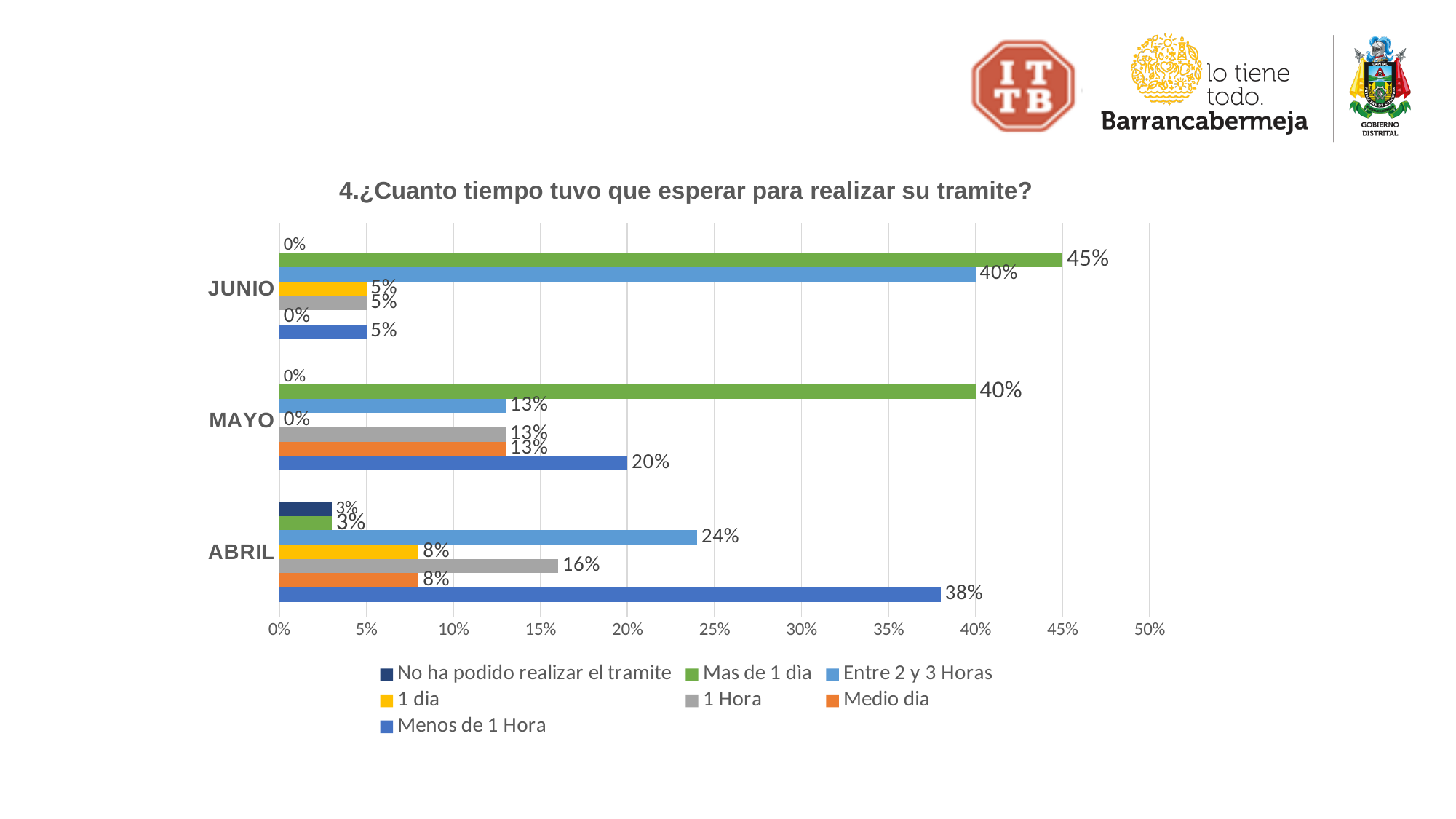
How many months (categories) are shown on the chart? 3 What is the value for 'Entre 2 y 3 Horas' in MAYO? 13% What is the value for 'Mas de 1 dia' in JUNIO? 45% How many series does the legend list? 7 What is the title of the chart? 4.¿Cuanto tiempo tuvo que esperar para realizar su tramite? What is the value for 'Menos de 1 Hora' in ABRIL? 38% What is the value for '1 Hora' in ABRIL? 16% What is the difference between 'Entre 2 y 3 Horas' in JUNIO and in ABRIL? 16% Which month has the lowest value for 'Menos de 1 Hora'? JUNIO Which month has the highest value for 'Mas de 1 dia'? JUNIO What kind of chart is shown on the slide? Bar chart Which is larger: 'Menos de 1 Hora' in MAYO or 'Entre 2 y 3 Horas' in MAYO? Menos de 1 Hora in MAYO